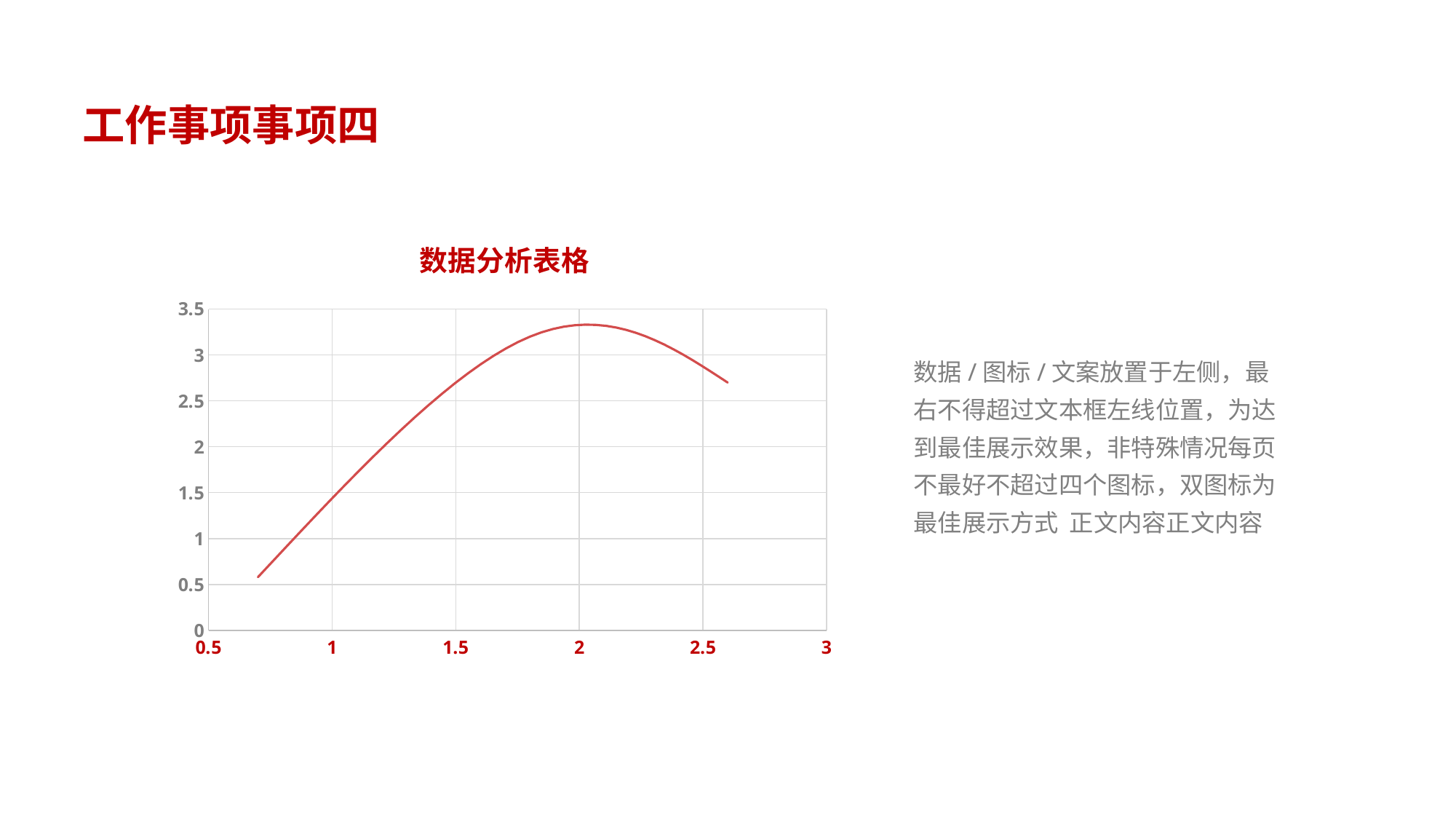
What is the maximum value shown on the vertical axis? 3.5 Does the line rise or fall between x = 2 and x = 2.5? fall Is the value of the line at x = 2.5 greater or less than 2.5? greater Is the value of the line at x = 2 greater or less than 3? greater What is the title of the chart? 数据分析表格 Is the highest point of the line greater or less than 3? greater What kind of chart is shown on the slide? line chart Does the line rise or fall between x = 0.5 and x = 2? rise